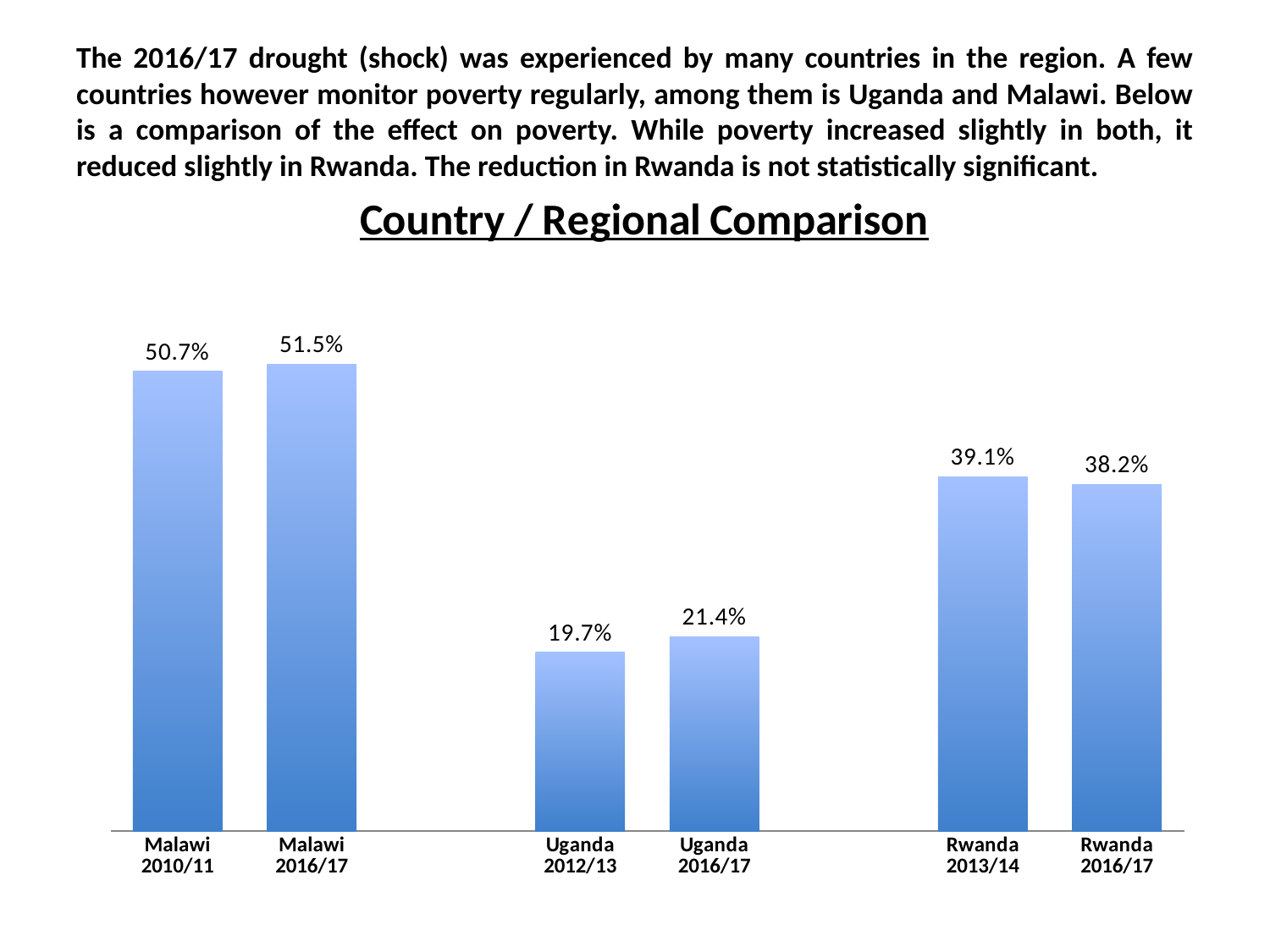
What is the value for Uganda 2016/17? 21.4% What is the difference between Rwanda 2013/14 and Rwanda 2016/17? 0.9% How many bars are plotted in the chart? 6 What is the value for Rwanda 2013/14? 39.1% What is the difference between Malawi 2016/17 and Malawi 2010/11? 0.8% What is the value for Malawi 2010/11? 50.7% Which is larger, the value for Uganda 2016/17 or Rwanda 2016/17? Rwanda 2016/17 Which category has the highest value? Malawi 2016/17 What kind of chart is shown on the slide? Bar chart What is the title of the chart? Country / Regional Comparison Did the value for Rwanda rise or fall from 2013/14 to 2016/17? Fall Which category has the lowest value? Uganda 2012/13